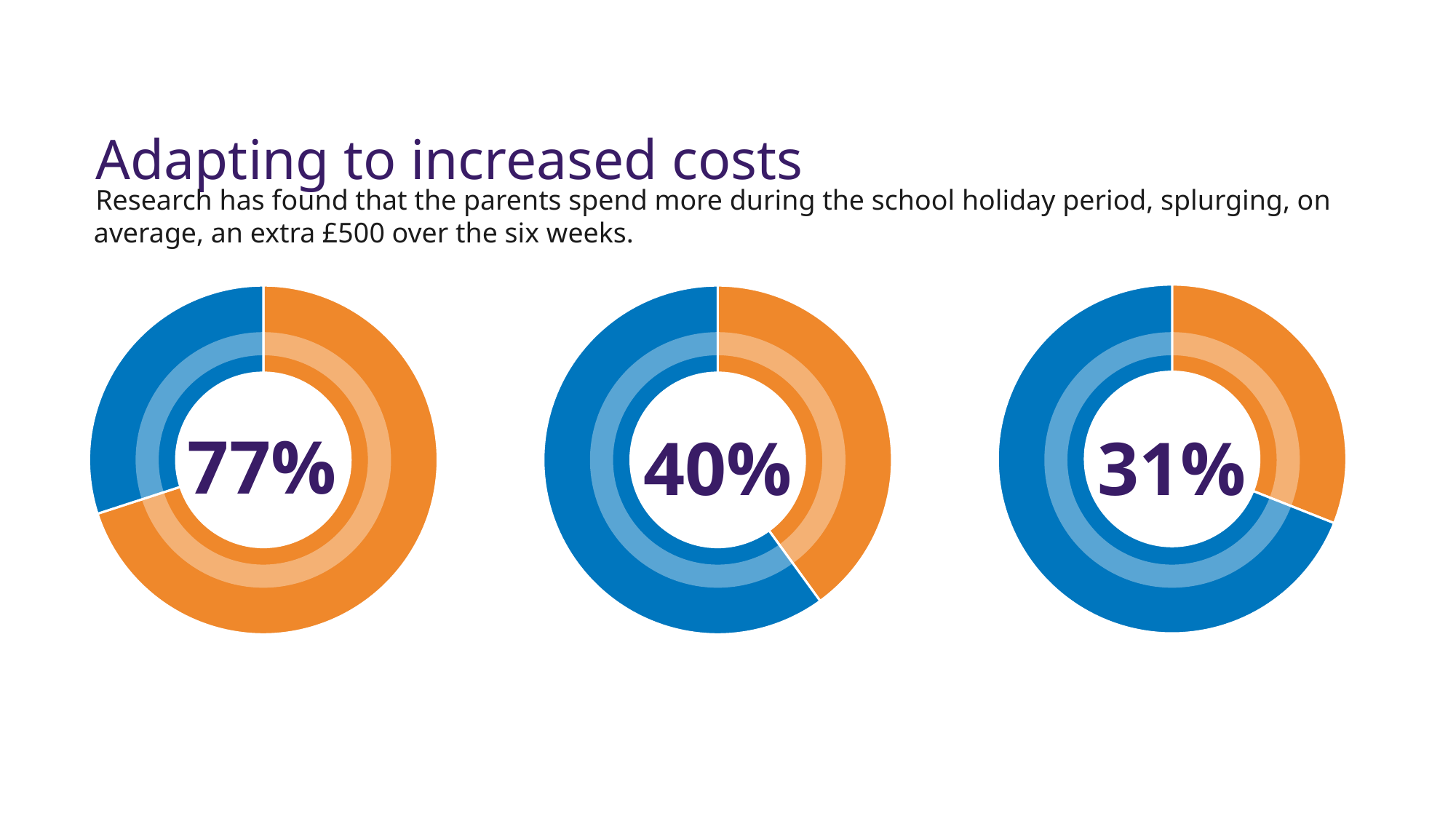
Is the value shown in the left donut chart greater or less than 50%? greater What is the difference between the percentage in the left donut chart and the percentage in the right donut chart? 46 percentage points What kind of chart is used to display the percentages on this slide? Donut (pie) chart What percentage is shown in the centre of the middle donut chart? 40% Is the percentage in the middle donut chart larger or smaller than the percentage in the right donut chart? Larger How many donut charts are on the slide? 3 What is the title of the slide containing the three donut charts? Adapting to increased costs What percentage is shown in the centre of the right donut chart? 31% What is the difference between the percentage in the left donut chart and the percentage in the middle donut chart? 37 percentage points What percentage is shown in the centre of the left donut chart? 77% Which of the three donut charts shows the highest percentage? The left chart (77%) Which of the three donut charts shows the lowest percentage? The right chart (31%)